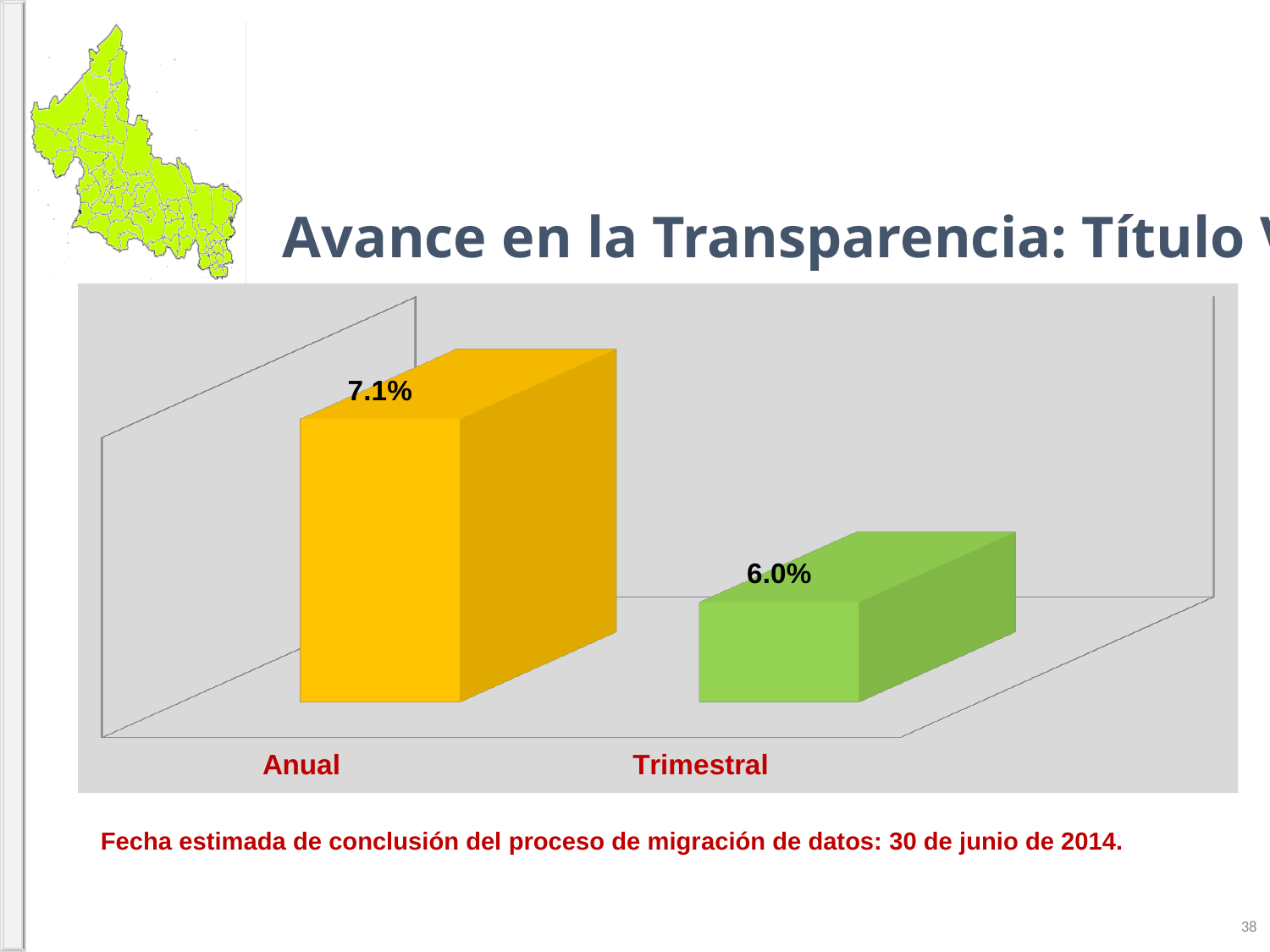
What kind of chart is shown on the slide? bar chart Which is larger, the value for Anual or the value for Trimestral? Anual Do the values rise or fall from Anual to Trimestral? fall What colour is the bar for Trimestral? green What colour is the bar for Anual? yellow/orange What is the difference between the values for Anual and Trimestral? 1.1% Which category has the lowest value? Trimestral What is the value for Anual? 7.1% Which category has the highest value? Anual How many categories are shown in the chart? 2 What is the value for Trimestral? 6.0%